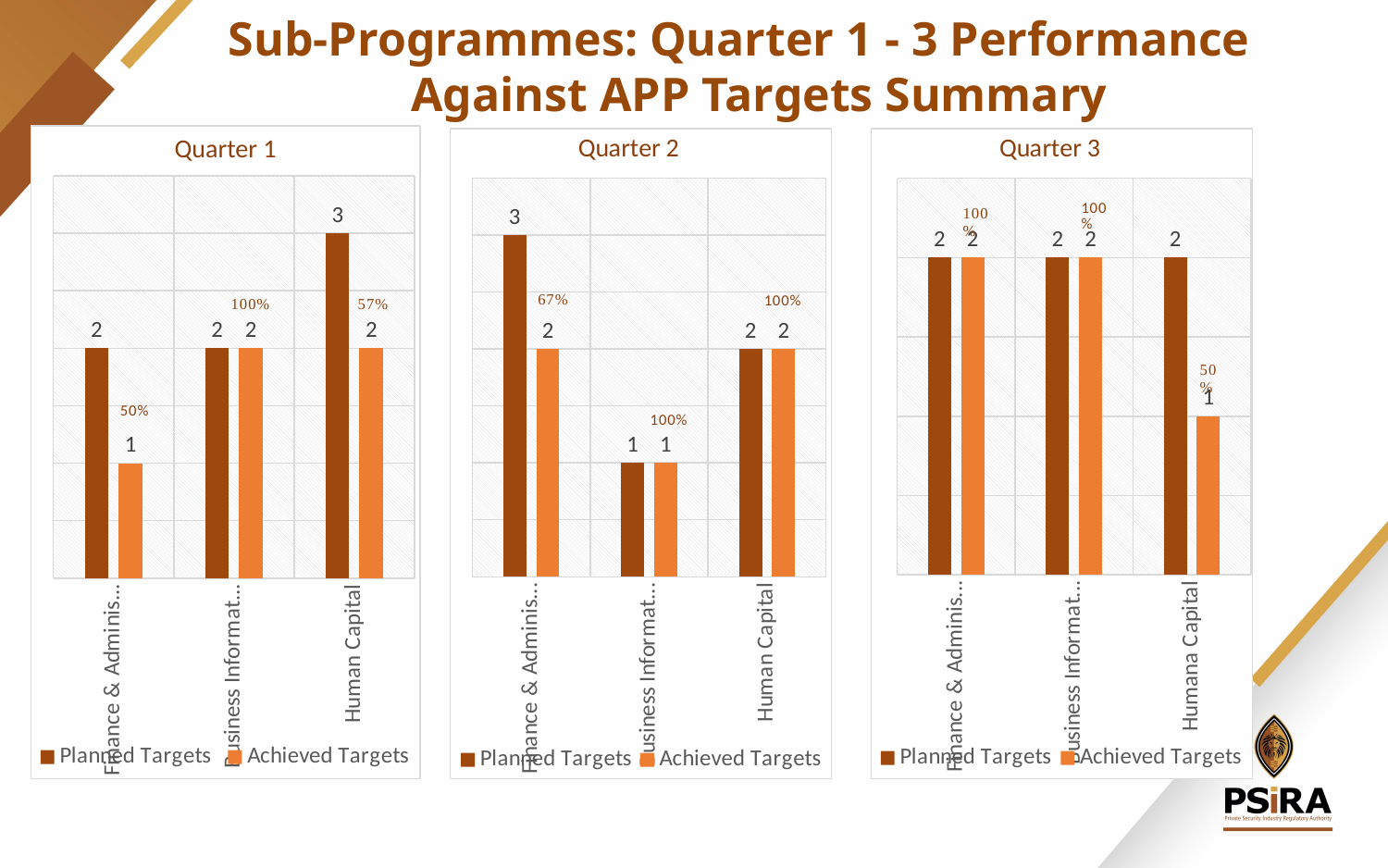
In the Quarter 1 chart, what is the difference between Planned Targets and Achieved Targets for Human Capital? 1 In the Quarter 2 chart, which category has the lowest Planned Targets value? Business Informat... In the Quarter 1 chart, what percentage label is shown above the Achieved Targets bar for Human Capital? 57% In the Quarter 2 chart, what is the Planned Targets value for the first category (Finance & Adminis...)? 3 How many categories are shown on the x axis of the Quarter 2 chart? 3 In the Quarter 1 chart, what is the Achieved Targets value for Human Capital? 2 In the Quarter 3 chart, is the Planned Targets value for Human Capital larger or smaller than the Achieved Targets value? larger In the Quarter 1 chart, what is the Planned Targets value for Human Capital? 3 How many series does the legend of the Quarter 1 chart list? 2 In the Quarter 2 chart, what percentage label is shown for the first category (Finance & Adminis...)? 67% What type of chart is the Quarter 3 chart? Bar chart In the Quarter 3 chart, what is the Achieved Targets value for Human Capital? 1